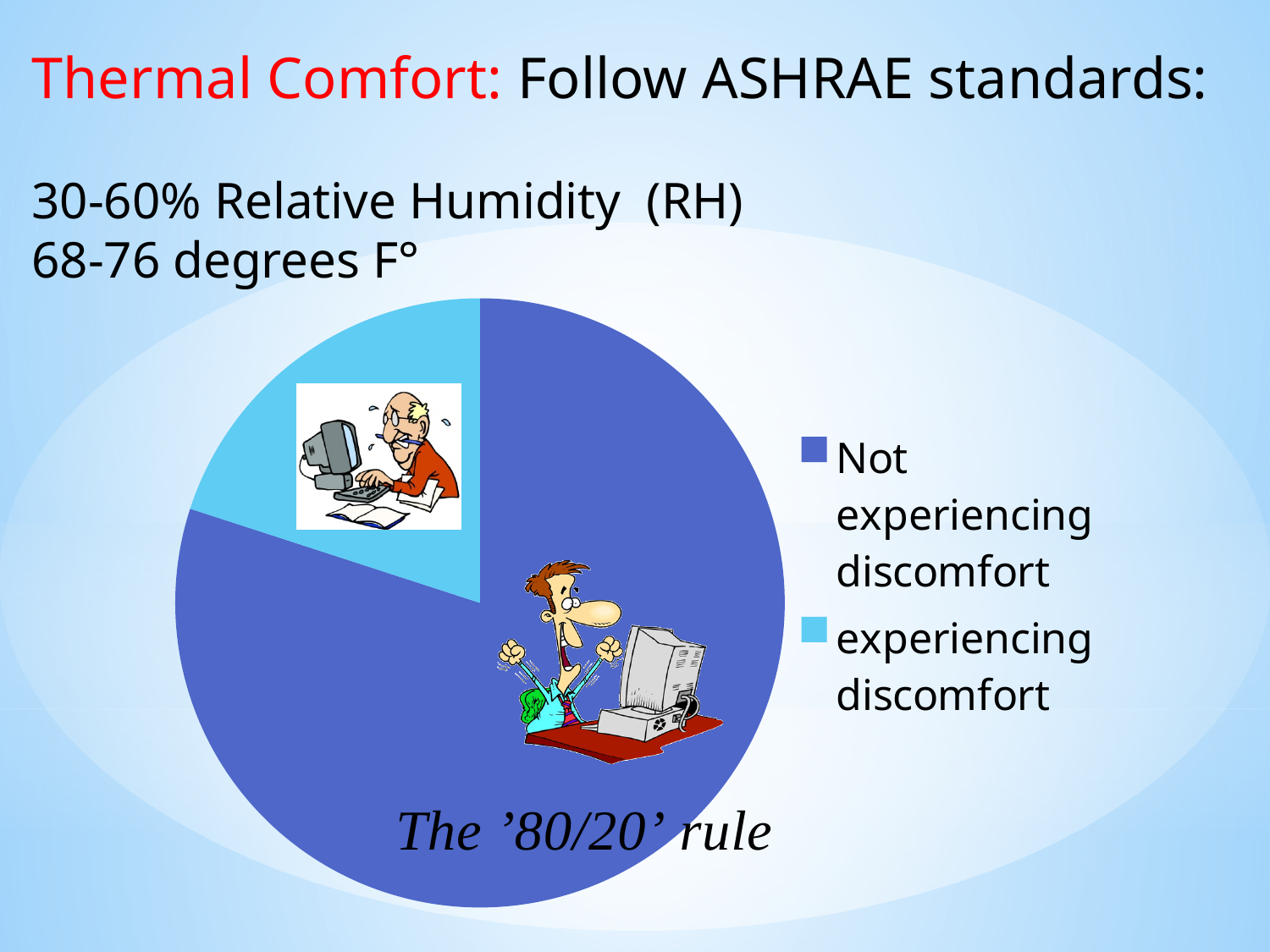
How many slices does the pie chart have? 2 Which slice of the pie chart is the smallest? experiencing discomfort How many entries does the legend of the pie chart list? 2 What colour is the 'Not experiencing discomfort' slice in the pie chart? dark blue Which slice of the pie chart is the largest? Not experiencing discomfort Which is larger in the pie chart: the 'Not experiencing discomfort' slice or the 'experiencing discomfort' slice? Not experiencing discomfort What kind of chart is shown on the slide? pie chart What colour is the 'experiencing discomfort' slice in the pie chart? light blue Does the 'Not experiencing discomfort' slice take up more or less than half of the pie chart? more